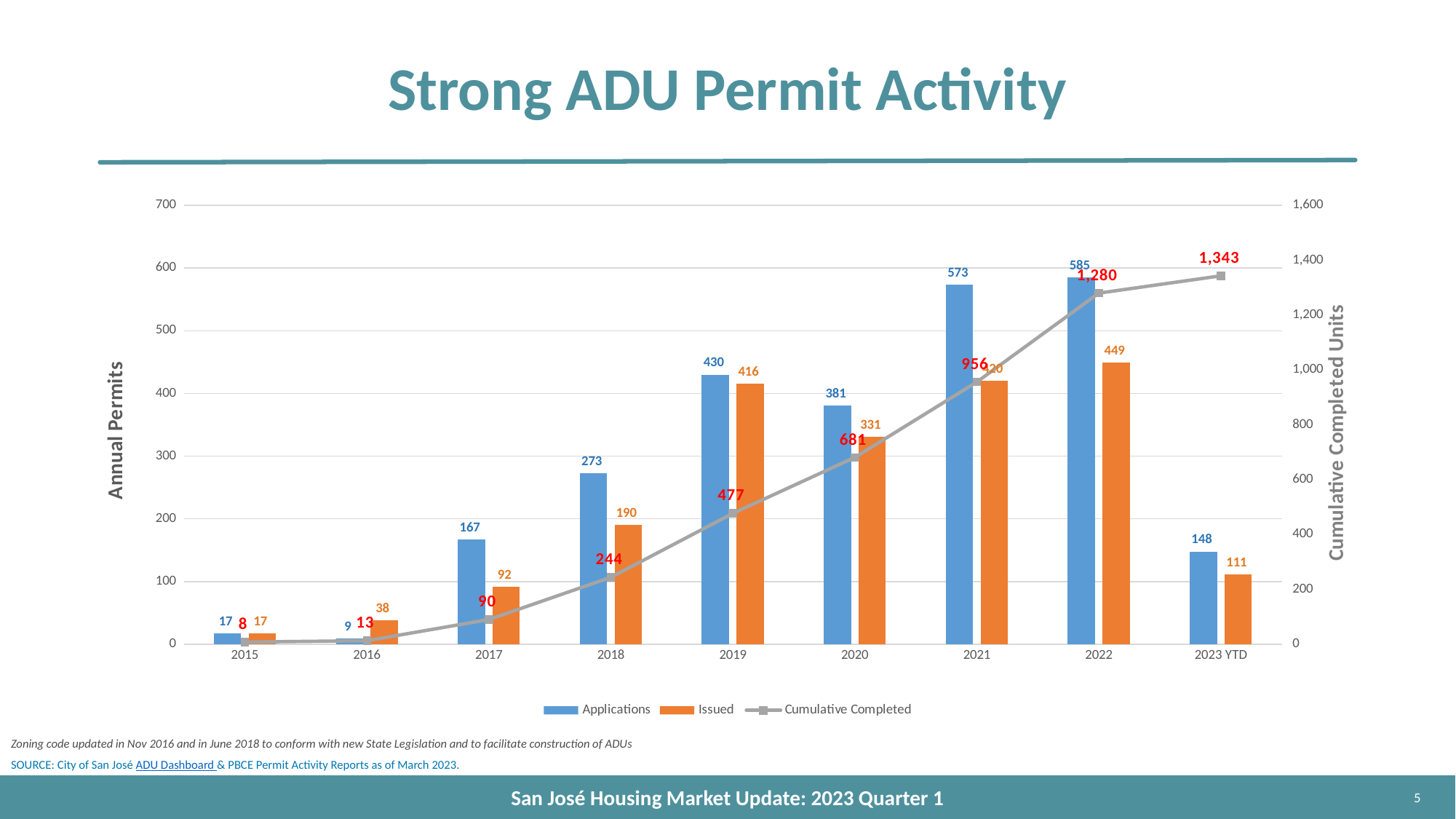
Which year has the lowest number of Applications? 2016 What is the Cumulative Completed value in 2018? 244 How many series does the legend list? 3 What is the value of Applications in 2019? 430 What kind of chart is this? Combination bar and line chart Which year has the highest number of Applications? 2022 In 2020, which is larger: Applications or Issued? Applications What is the difference between Applications and Issued in 2022? 136 What is the Cumulative Completed value for 2023 YTD? 1,343 How many years (categories) are shown on the x axis? 9 How many permits were Issued in 2022? 449 Does the Cumulative Completed line rise or fall from 2015 to 2023 YTD? Rises